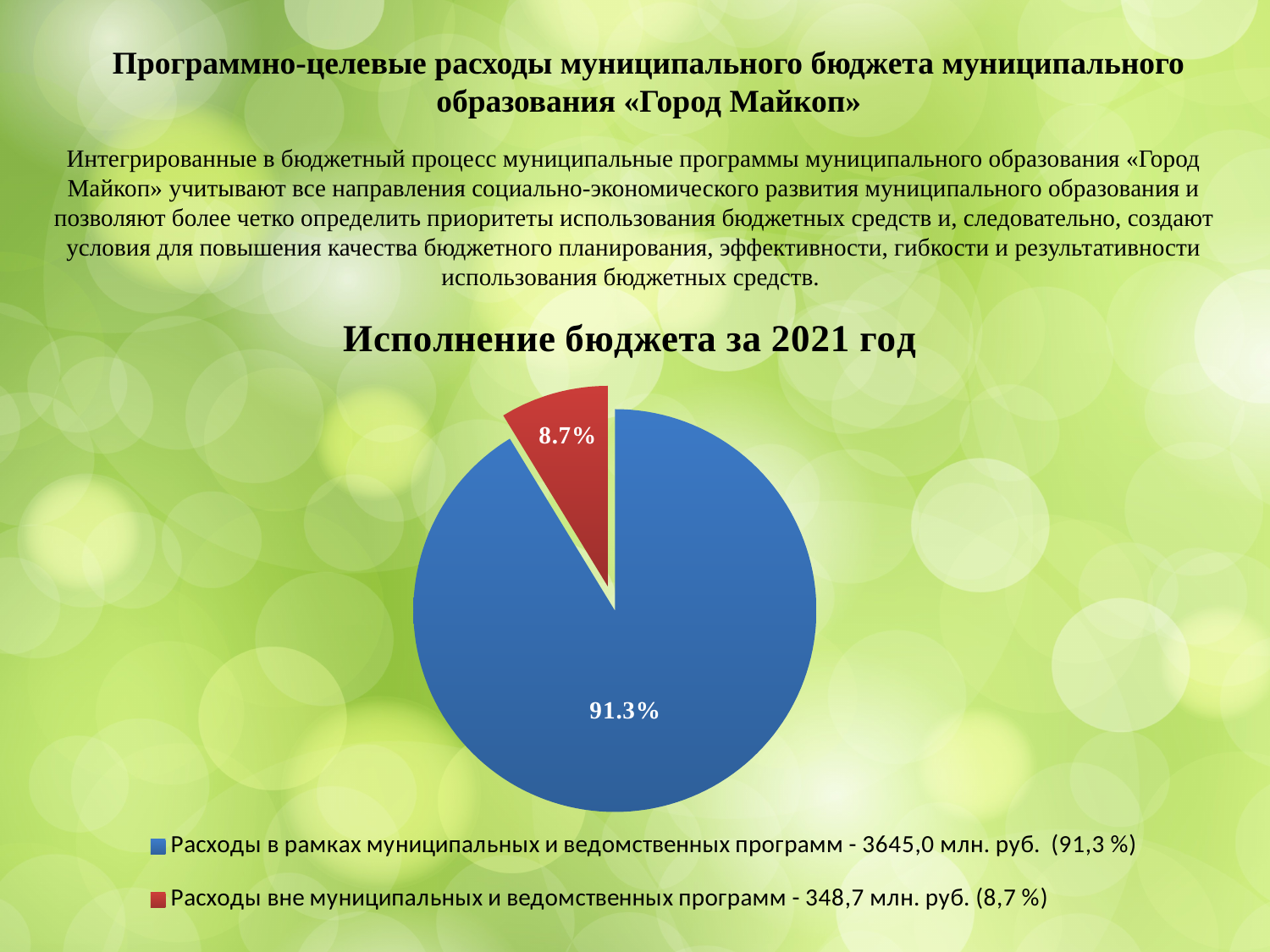
Which slice is the largest in the pie chart? Расходы в рамках муниципальных и ведомственных программ What share of the pie is labelled for "Расходы в рамках муниципальных и ведомственных программ"? 91.3% What kind of chart is shown under the title "Исполнение бюджета за 2021 год"? pie chart What share of the pie is labelled for "Расходы вне муниципальных и ведомственных программ"? 8.7% Which slice is the smallest in the pie chart? Расходы вне муниципальных и ведомственных программ What colour is the slice for "Расходы в рамках муниципальных и ведомственных программ"? blue How many slices does the pie chart have? 2 What is the difference in percentage points between the two slices of the pie chart? 82.6 What is the title of the chart? Исполнение бюджета за 2021 год Which is larger: the share for expenses within municipal and departmental programs or the share for expenses outside them? Расходы в рамках муниципальных и ведомственных программ According to the legend, what amount in million rubles corresponds to "Расходы вне муниципальных и ведомственных программ"? 348,7 млн. руб. How many entries does the legend list? 2